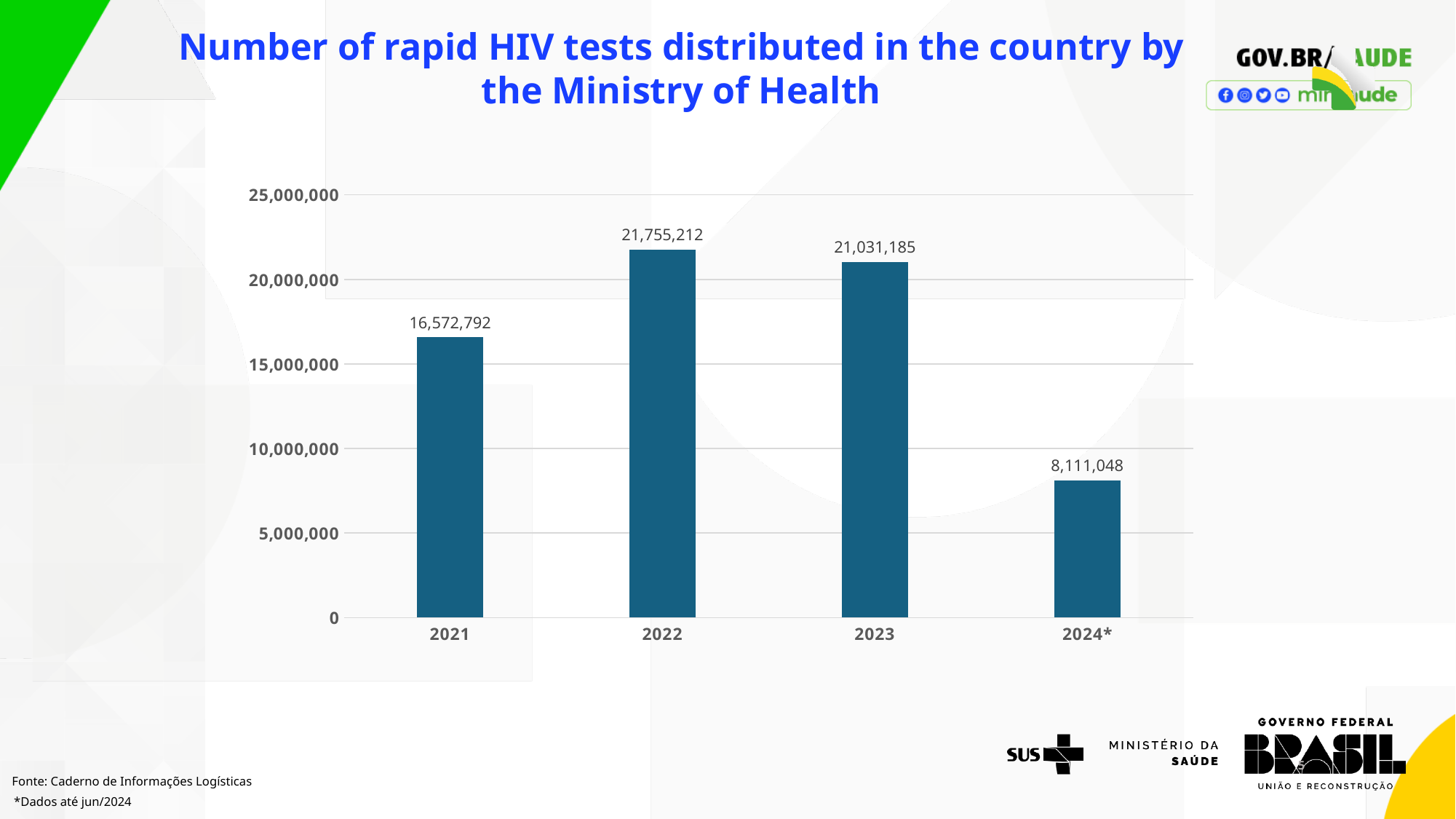
From 2022 to 2024*, do the values rise or fall? fall How many rapid HIV tests were distributed in 2021? 16,572,792 Which year has the lowest number of rapid HIV tests distributed? 2024* What kind of chart is shown on the slide? bar chart What is the value shown for 2022? 21,755,212 Is the value for 2024* greater or less than 10,000,000? less Which year has the highest number of rapid HIV tests distributed? 2022 What is the difference between the values for 2022 and 2023? 724,027 What is the difference between the values for 2022 and 2021? 5,182,420 How many years are shown on the x axis? 4 Which is larger, the value for 2021 or the value for 2023? 2023 What is the value shown for 2024*? 8,111,048